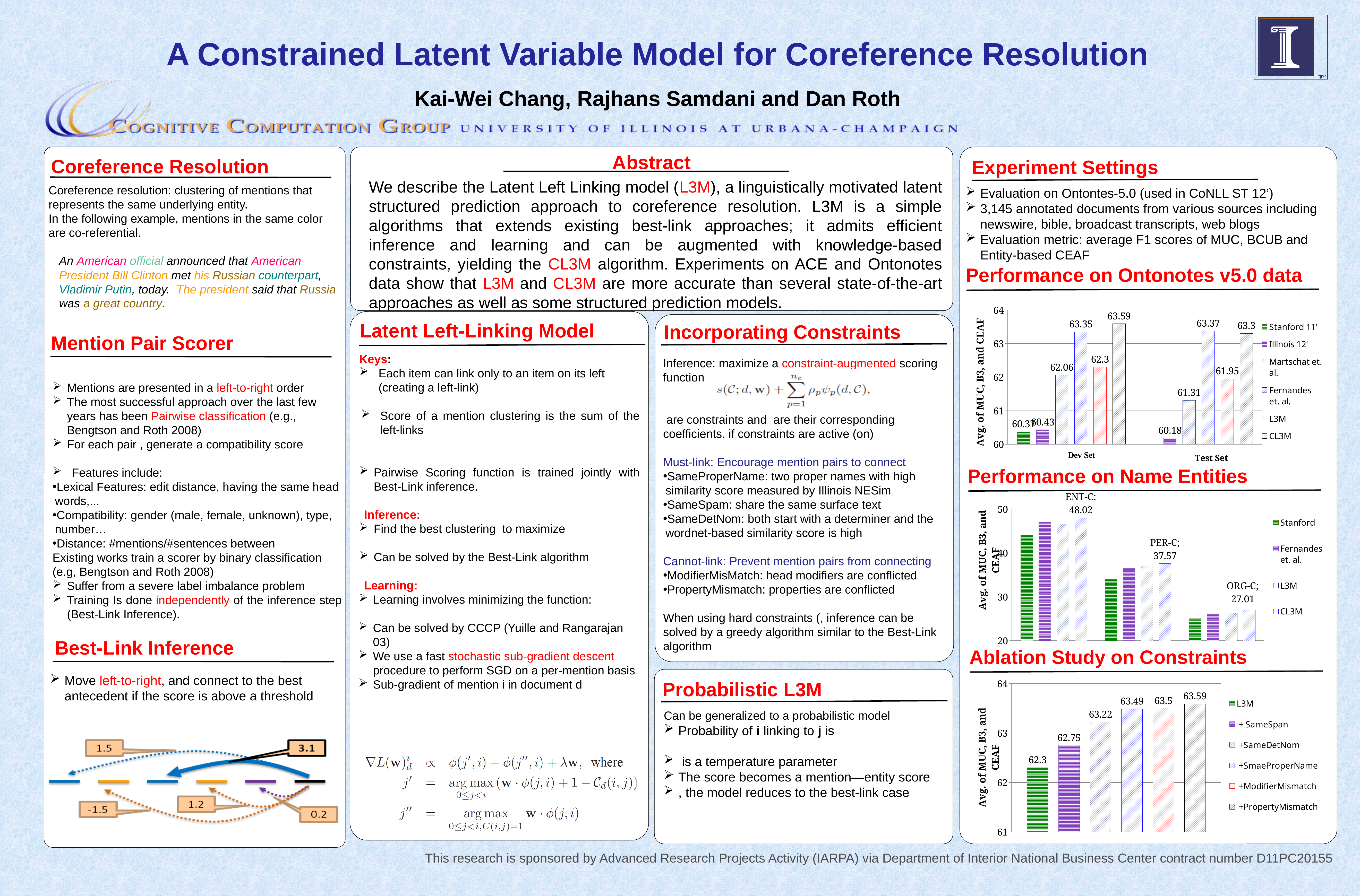
In the 'Performance on Ontonotes v5.0 data' chart, how many series does the legend list? 6 In the 'Ablation Study on Constraints' chart, what is the difference between +SameSpan and L3M? 0.45 In the 'Performance on Ontonotes v5.0 data' chart, what is the value for CL3M on the Dev Set? 63.59 In the 'Performance on Name Entities' chart, what is the value for CL3M on ORG-C? 27.01 In the 'Performance on Name Entities' chart, is the value for Stanford on ENT-C greater or less than 40? greater In the 'Performance on Ontonotes v5.0 data' chart, what is the value for L3M on the Test Set? 61.95 In the 'Performance on Ontonotes v5.0 data' chart, what is the difference between CL3M and L3M on the Dev Set? 1.29 In the 'Ablation Study on Constraints' chart, which series has the highest value? +PropertyMismatch In the 'Performance on Name Entities' chart, how many entity categories are shown on the x axis? 3 In the 'Performance on Name Entities' chart, what is the value for CL3M on ENT-C? 48.02 In the 'Performance on Ontonotes v5.0 data' chart, is the value for Martschat et. al. on the Test Set greater or less than 62? less